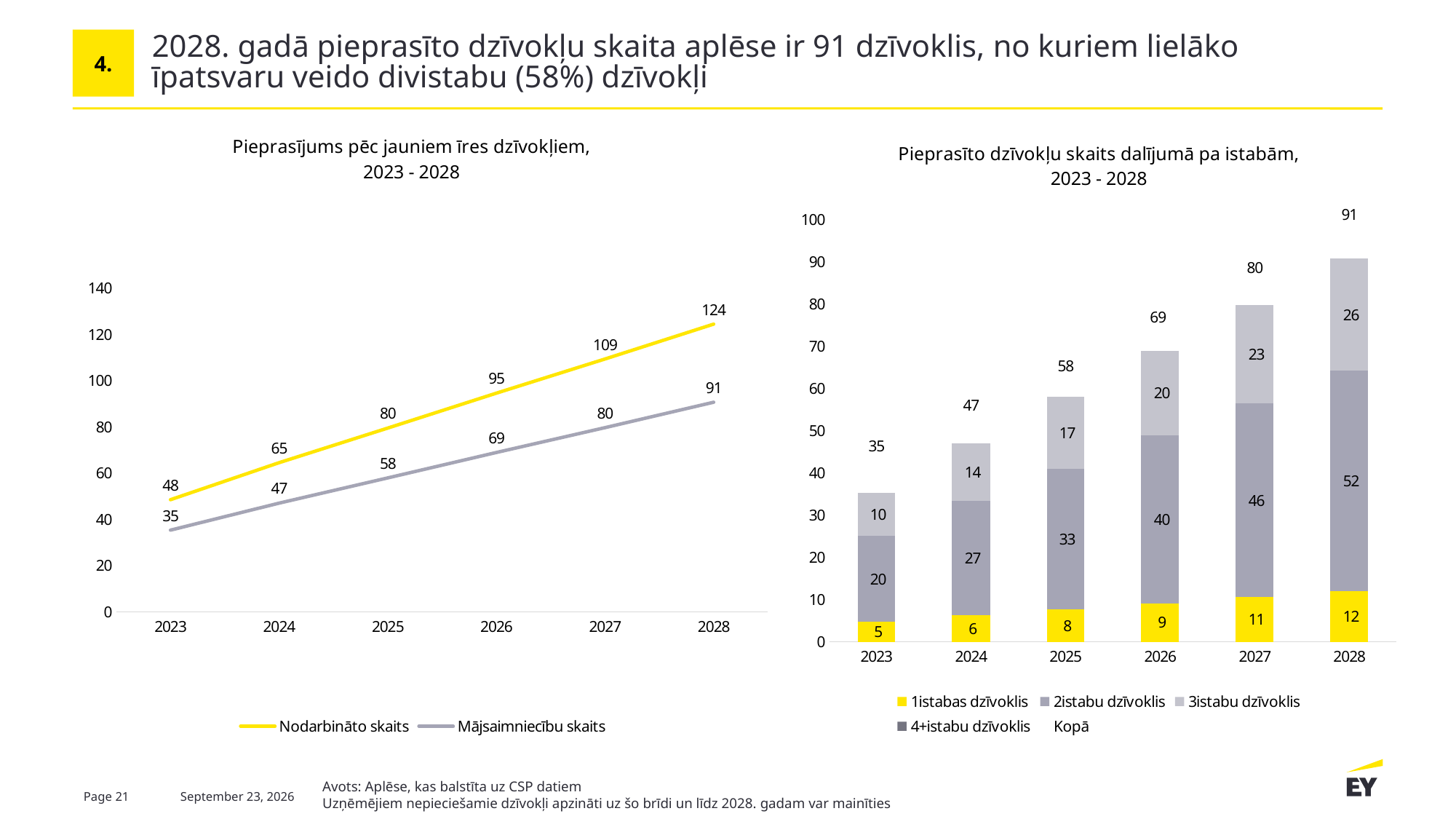
In the chart 'Pieprasīto dzīvokļu skaits dalījumā pa istabām, 2023 - 2028', which is larger: 3istabu dzīvoklis in 2026 or 1istabas dzīvoklis in 2028? 3istabu dzīvoklis in 2026 What kind of chart is 'Pieprasīto dzīvokļu skaits dalījumā pa istabām, 2023 - 2028'? stacked bar chart How many series does the legend of the chart 'Pieprasījums pēc jauniem īres dzīvokļiem, 2023 - 2028' list? 2 How many years are shown on the x axis of the chart 'Pieprasīto dzīvokļu skaits dalījumā pa istabām, 2023 - 2028'? 6 In the chart 'Pieprasīto dzīvokļu skaits dalījumā pa istabām, 2023 - 2028', what is the total of the stacked bar for 2025? 58 In the chart 'Pieprasīto dzīvokļu skaits dalījumā pa istabām, 2023 - 2028', what is the value for 2istabu dzīvoklis in 2027? 46 In the chart 'Pieprasījums pēc jauniem īres dzīvokļiem, 2023 - 2028', what is the value of Nodarbināto skaits in 2026? 95 In the chart 'Pieprasījums pēc jauniem īres dzīvokļiem, 2023 - 2028', what is the value of Mājsaimniecību skaits in 2024? 47 In the chart 'Pieprasījums pēc jauniem īres dzīvokļiem, 2023 - 2028', what is the difference between Nodarbināto skaits and Mājsaimniecību skaits in 2028? 33 In the chart 'Pieprasījums pēc jauniem īres dzīvokļiem, 2023 - 2028', do the values of Nodarbināto skaits rise or fall from 2023 to 2028? rise In the chart 'Pieprasīto dzīvokļu skaits dalījumā pa istabām, 2023 - 2028', which year has the lowest total? 2023 What kind of chart is 'Pieprasījums pēc jauniem īres dzīvokļiem, 2023 - 2028'? line chart